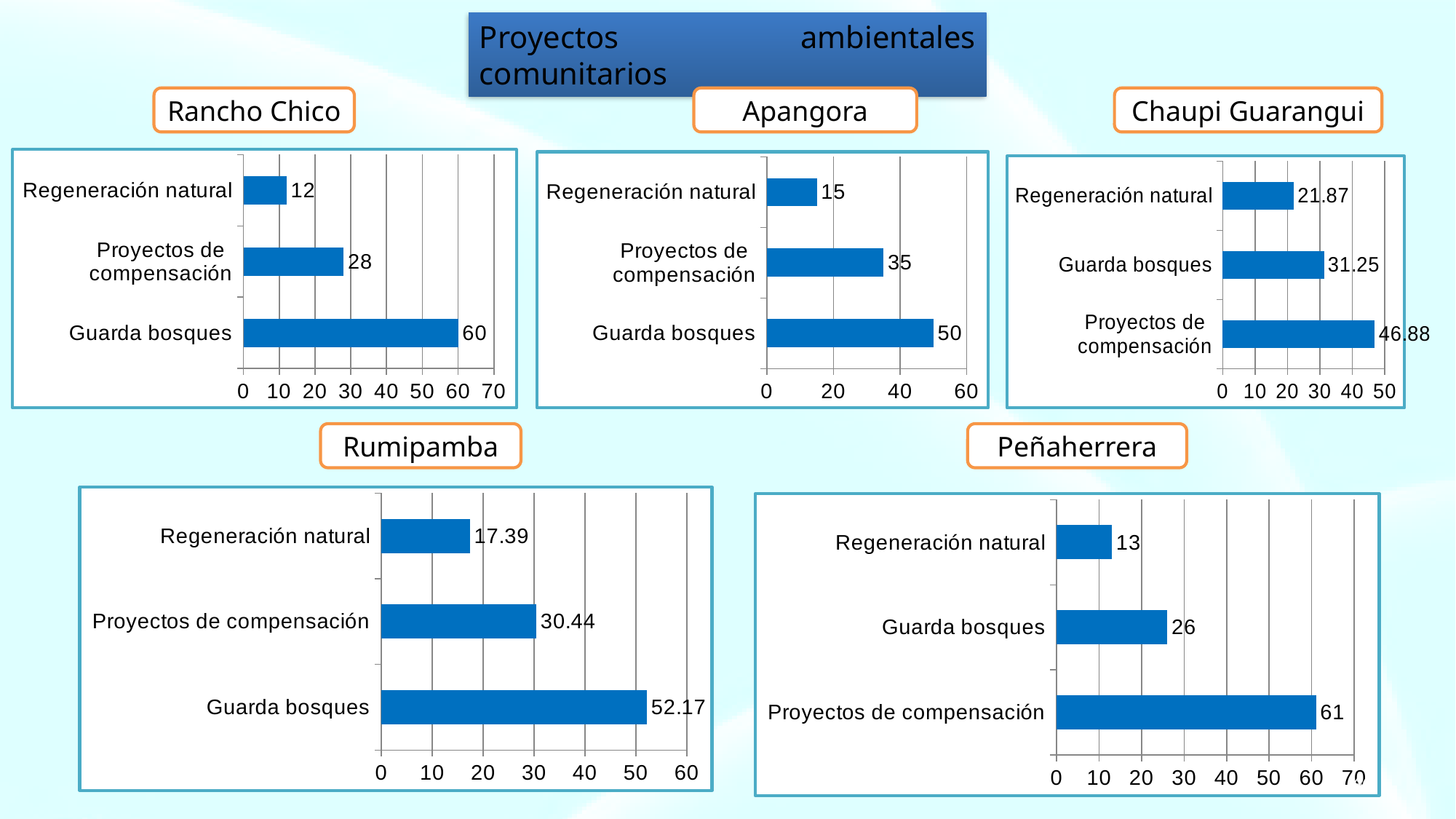
In the Rumipamba chart, what is the value for Guarda bosques? 52.17 In the Chaupi Guarangui chart, what is the value for Regeneración natural? 21.87 What type of chart is the Apangora chart? Bar chart In the Apangora chart, what is the value for Proyectos de compensación? 35 In the Rancho Chico chart, what is the value for Guarda bosques? 60 How many categories does the Rumipamba chart show? 3 In the Peñaherrera chart, which category has the highest value? Proyectos de compensación In the Rancho Chico chart, what is the difference between Guarda bosques and Regeneración natural? 48 In the Peñaherrera chart, what is the difference between Proyectos de compensación and Guarda bosques? 35 How many charts are shown on the slide? 5 In the Chaupi Guarangui chart, which category has the lowest value? Regeneración natural In the Apangora chart, which is larger: Guarda bosques or Regeneración natural? Guarda bosques